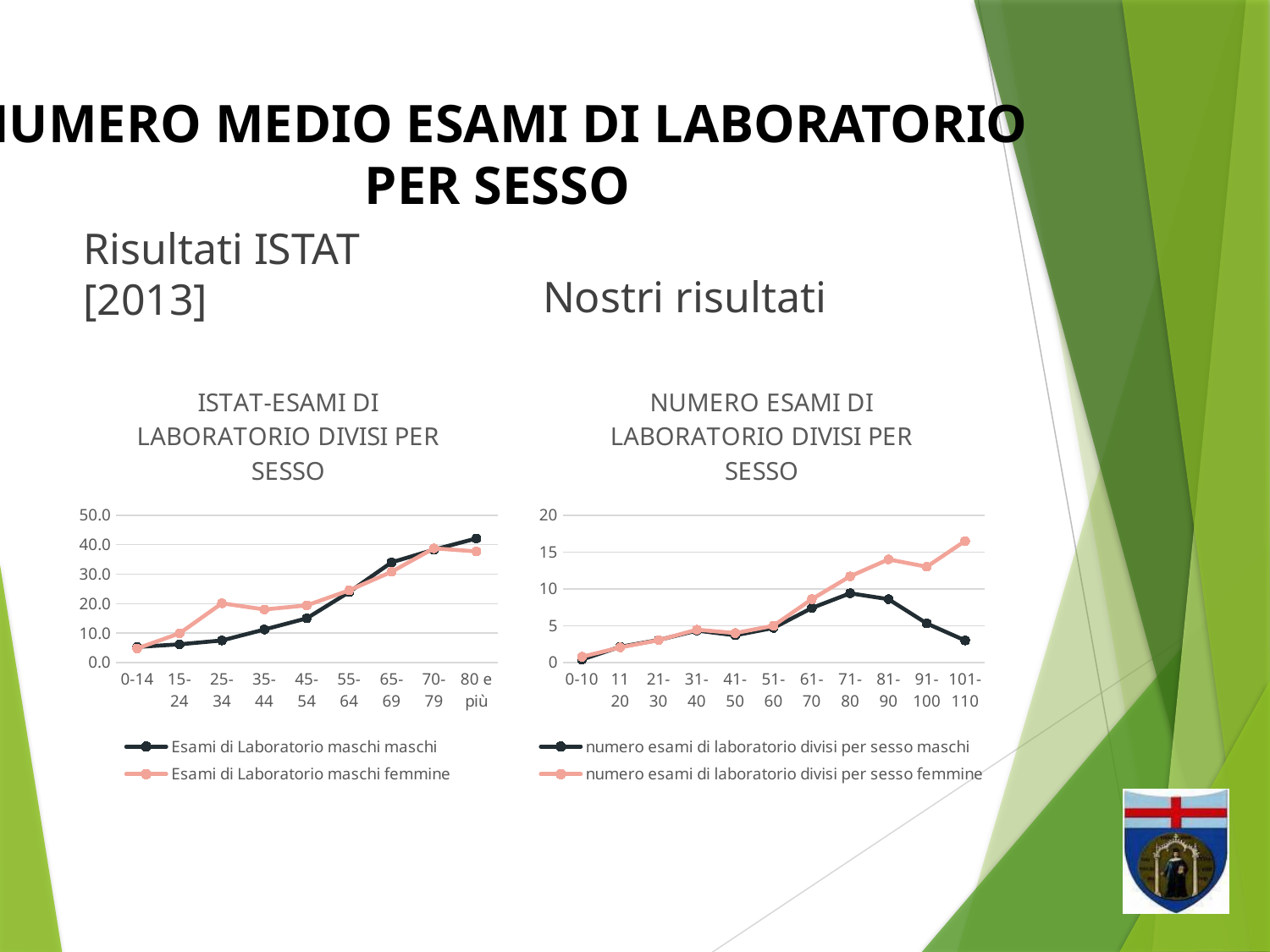
In the chart titled "ISTAT-ESAMI DI LABORATORIO DIVISI PER SESSO", is the value for maschi at "80 e più" greater or less than 40.0? greater In the chart titled "NUMERO ESAMI DI LABORATORIO DIVISI PER SESSO", does the femmine series generally rise or fall from "0-10" to "101-110"? rise How many age categories are shown on the x axis of the chart titled "ISTAT-ESAMI DI LABORATORIO DIVISI PER SESSO"? 9 How many series does the legend of the chart titled "NUMERO ESAMI DI LABORATORIO DIVISI PER SESSO" list? 2 What type of chart is the chart titled "ISTAT-ESAMI DI LABORATORIO DIVISI PER SESSO"? line chart In the chart titled "NUMERO ESAMI DI LABORATORIO DIVISI PER SESSO", which age category has the highest value for femmine? 101-110 In the chart titled "ISTAT-ESAMI DI LABORATORIO DIVISI PER SESSO", at age "25-34", which series has the larger value, maschi or femmine? femmine In the chart titled "NUMERO ESAMI DI LABORATORIO DIVISI PER SESSO", is the value for maschi at "101-110" greater or less than 5? less How many age categories are shown on the x axis of the chart titled "NUMERO ESAMI DI LABORATORIO DIVISI PER SESSO"? 11 In the chart titled "ISTAT-ESAMI DI LABORATORIO DIVISI PER SESSO", is the value for femmine at "35-44" greater or less than 20.0? less In the chart titled "NUMERO ESAMI DI LABORATORIO DIVISI PER SESSO", which age category has the lowest value for femmine? 0-10